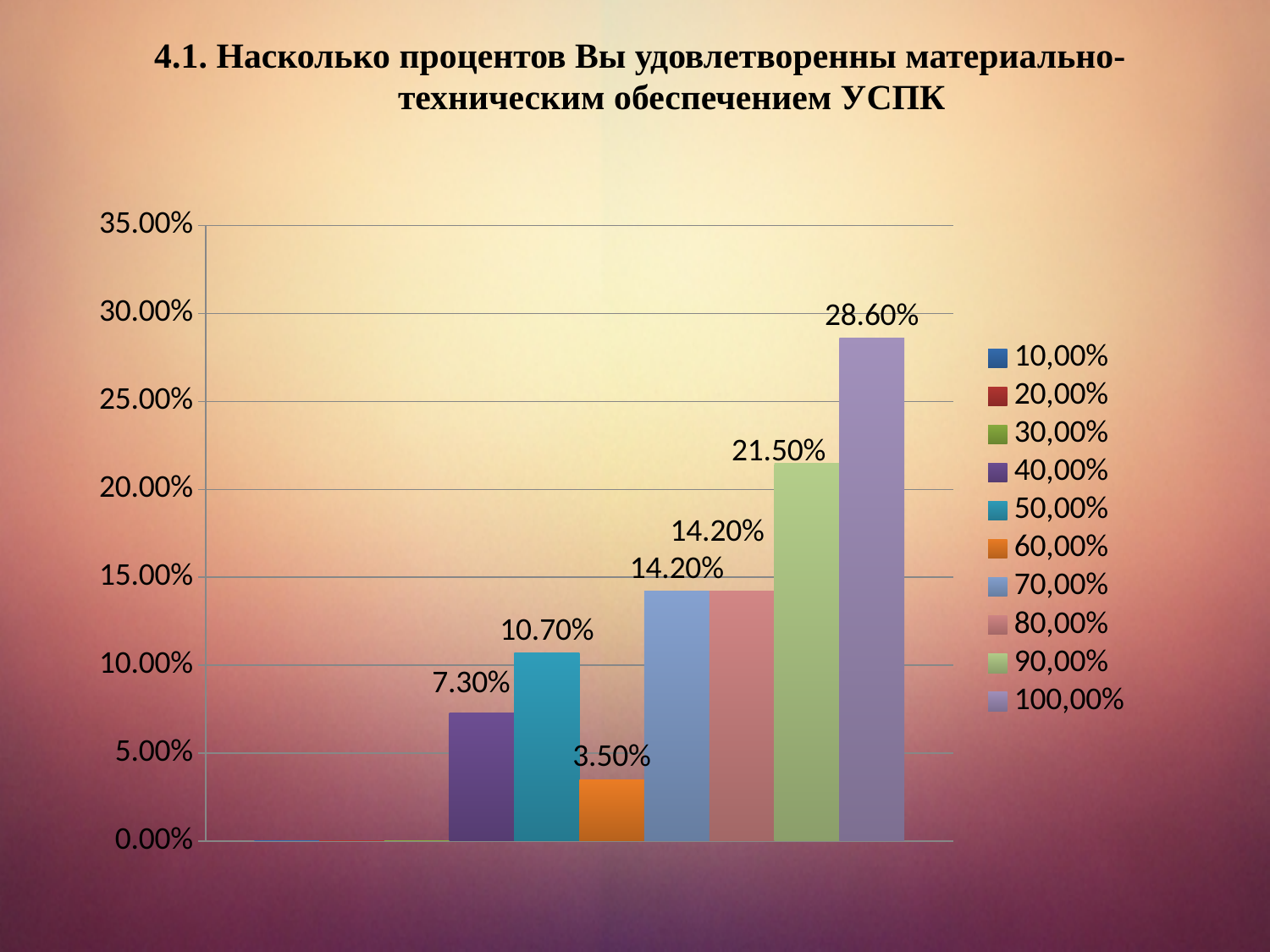
Which series has the highest value? 100,00% What is the difference between the values for the 100,00% and 90,00% series? 7.10% What is the value for the 50,00% series? 10.70% What is the value for the 60,00% series? 3.50% What is the value for the 90,00% series? 21.50% What is the title of the chart? 4.1. Насколько процентов Вы удовлетворенны материально-техническим обеспечением УСПК Which is larger, the value for the 50,00% series or the 40,00% series? 50,00% What type of chart is shown on the slide? bar chart How many series does the legend list? 10 What is the value for the 40,00% series? 7.30% Among the bars shown with data labels, which series has the lowest value? 60,00% What is the value for the 100,00% series? 28.60%